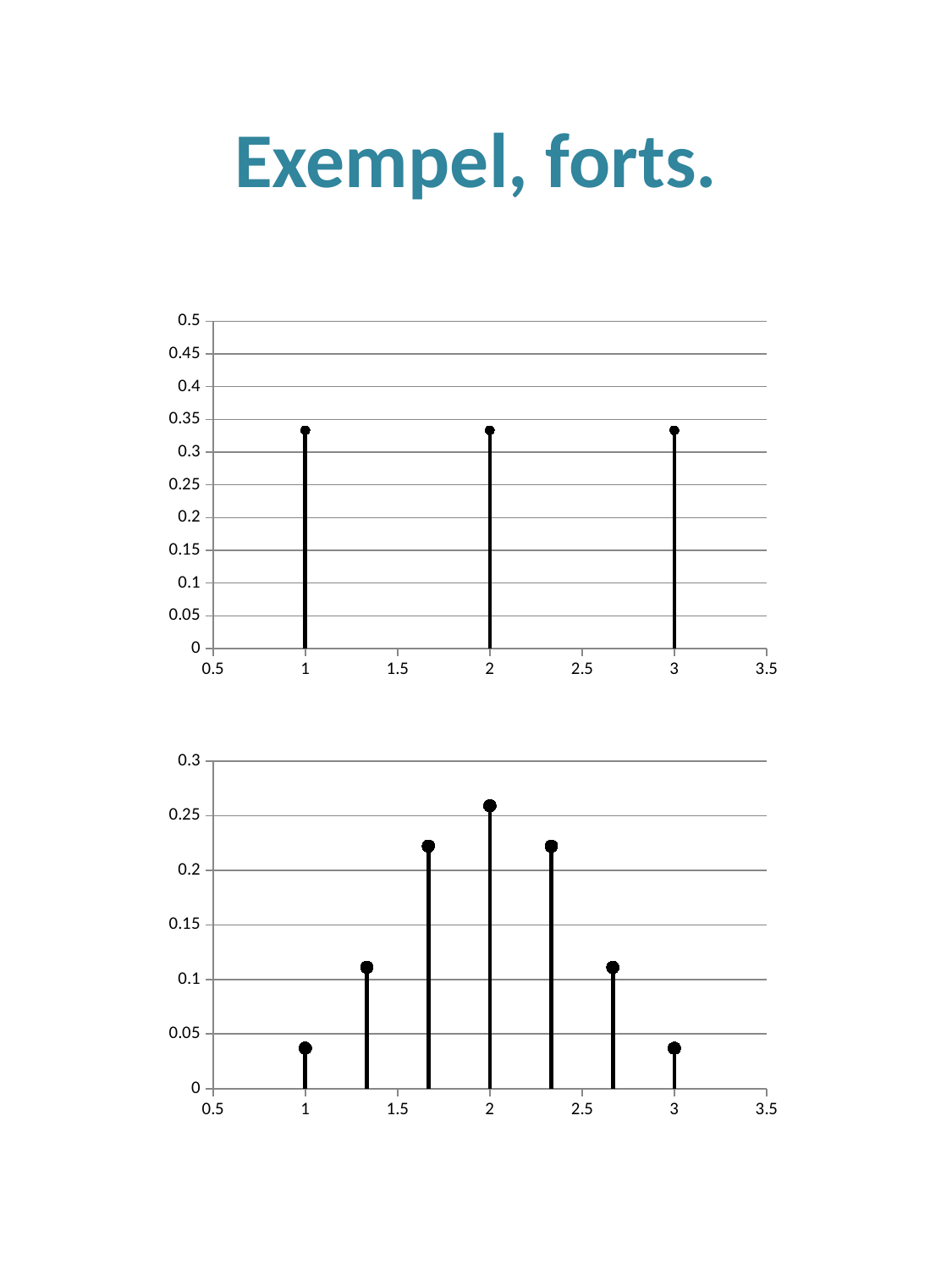
In the bottom chart, is the value at x = 1 greater or less than 0.05? less In the bottom chart, do the values rise or fall as x goes from 1 to 2? rise In the top chart, how many data points are plotted? 3 In the top chart, is the value at x = 2 greater or less than 0.35? less In the bottom chart, at which x value is the plotted value highest? 2 In the bottom chart, what is the highest value shown on the y axis? 0.3 In the bottom chart, how many data points are plotted? 7 In the bottom chart, is the value at x = 2 greater or less than 0.25? greater In the top chart, what is the highest value shown on the y axis? 0.5 In the bottom chart, which is larger: the value at x = 2 or the value at x = 1? x = 2